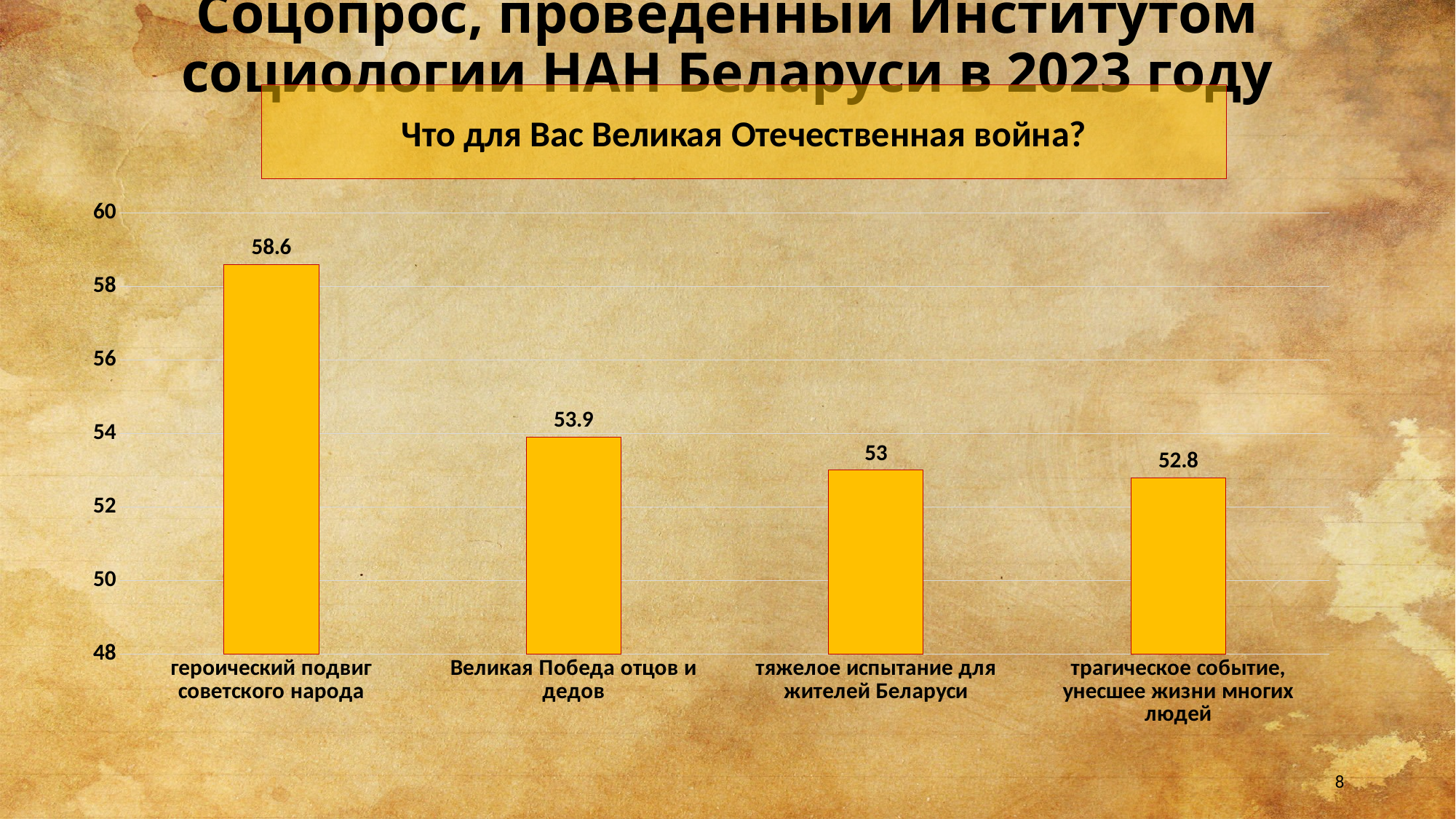
What is the difference between the values for "героический подвиг советского народа" and "Великая Победа отцов и дедов"? 4.7 What is the value for "героический подвиг советского народа"? 58.6 What is the title of the chart? Что для Вас Великая Отечественная война? Is the value for "героический подвиг советского народа" greater or less than 56? greater Which category has the highest value? героический подвиг советского народа How many categories are shown in the chart? 4 What is the value for "трагическое событие, унесшее жизни многих людей"? 52.8 Which category has the lowest value? трагическое событие, унесшее жизни многих людей Which is larger: the value for "Великая Победа отцов и дедов" or for "тяжелое испытание для жителей Беларуси"? Великая Победа отцов и дедов What is the value for "тяжелое испытание для жителей Беларуси"? 53 What is the value for "Великая Победа отцов и дедов"? 53.9 What kind of chart is shown on the slide? bar chart